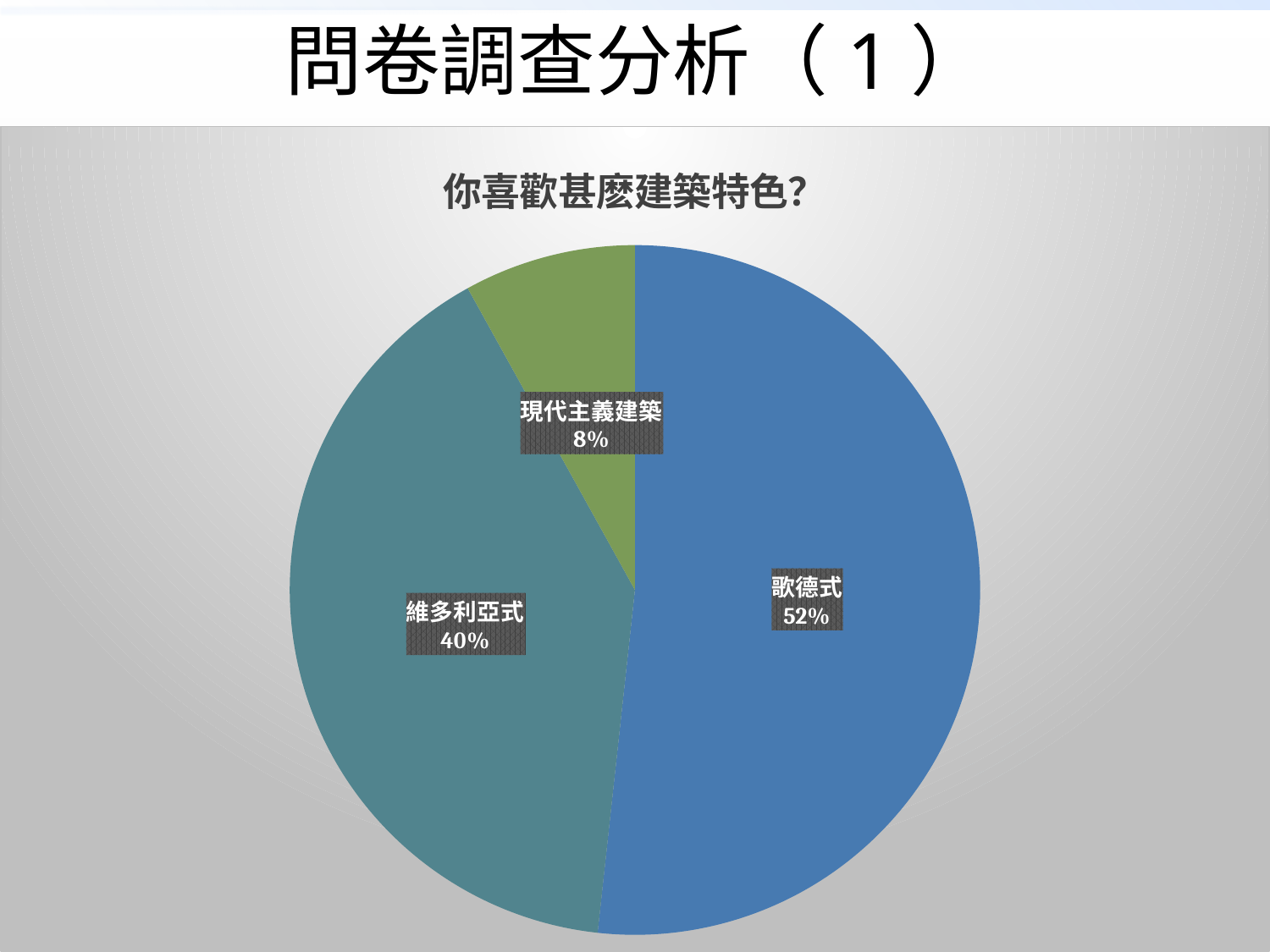
What is the difference in percentage points between 歌德式 and 維多利亞式? 12% Which is larger, the share for 維多利亞式 or the share for 現代主義建築? 維多利亞式 What is the difference in percentage points between 維多利亞式 and 現代主義建築? 32% What share of the pie does 歌德式 have? 52% What colour is the slice for 現代主義建築? green Which category has the largest slice? 歌德式 What share of the pie does 現代主義建築 have? 8% What is the title of the chart? 你喜歡甚麽建築特色? Which category has the smallest slice? 現代主義建築 What kind of chart is shown on the slide? pie chart What share of the pie does 維多利亞式 have? 40% How many categories are shown in the pie chart? 3